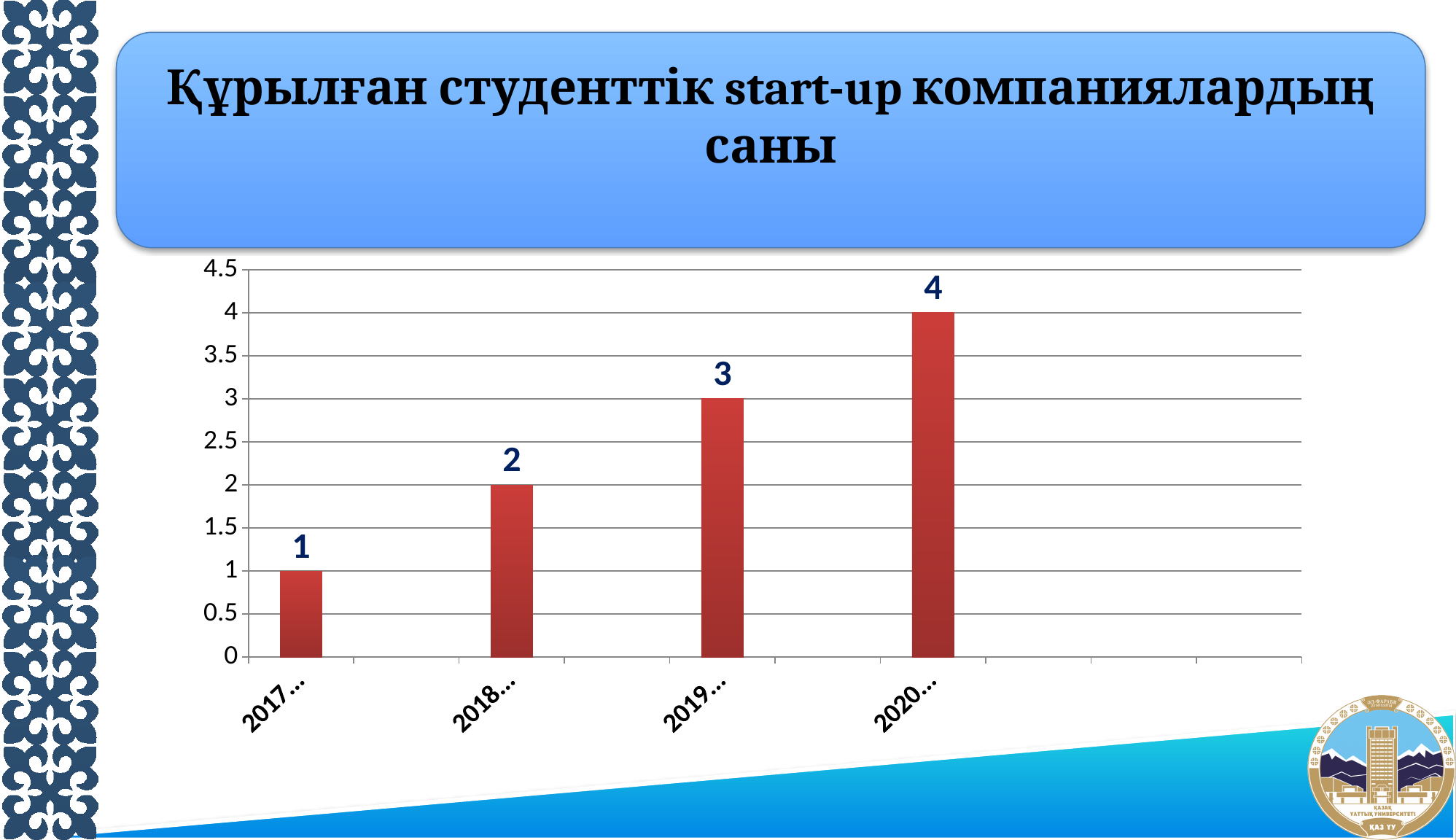
How many bars are shown in the chart? 4 What is the maximum value shown on the vertical axis? 4.5 What is the value of the bar for 2020? 4 Which year has the highest value? 2020 Which year has the lowest value? 2017 Is the value for 2020 greater or less than 3.5? greater Do the values rise or fall from 2017 to 2020? rise Which is larger, the value for 2018 or the value for 2019? 2019 What kind of chart is shown on the slide? bar chart What is the value of the bar for 2019? 3 What is the value of the bar for 2017? 1 What is the difference between the values for 2020 and 2018? 2